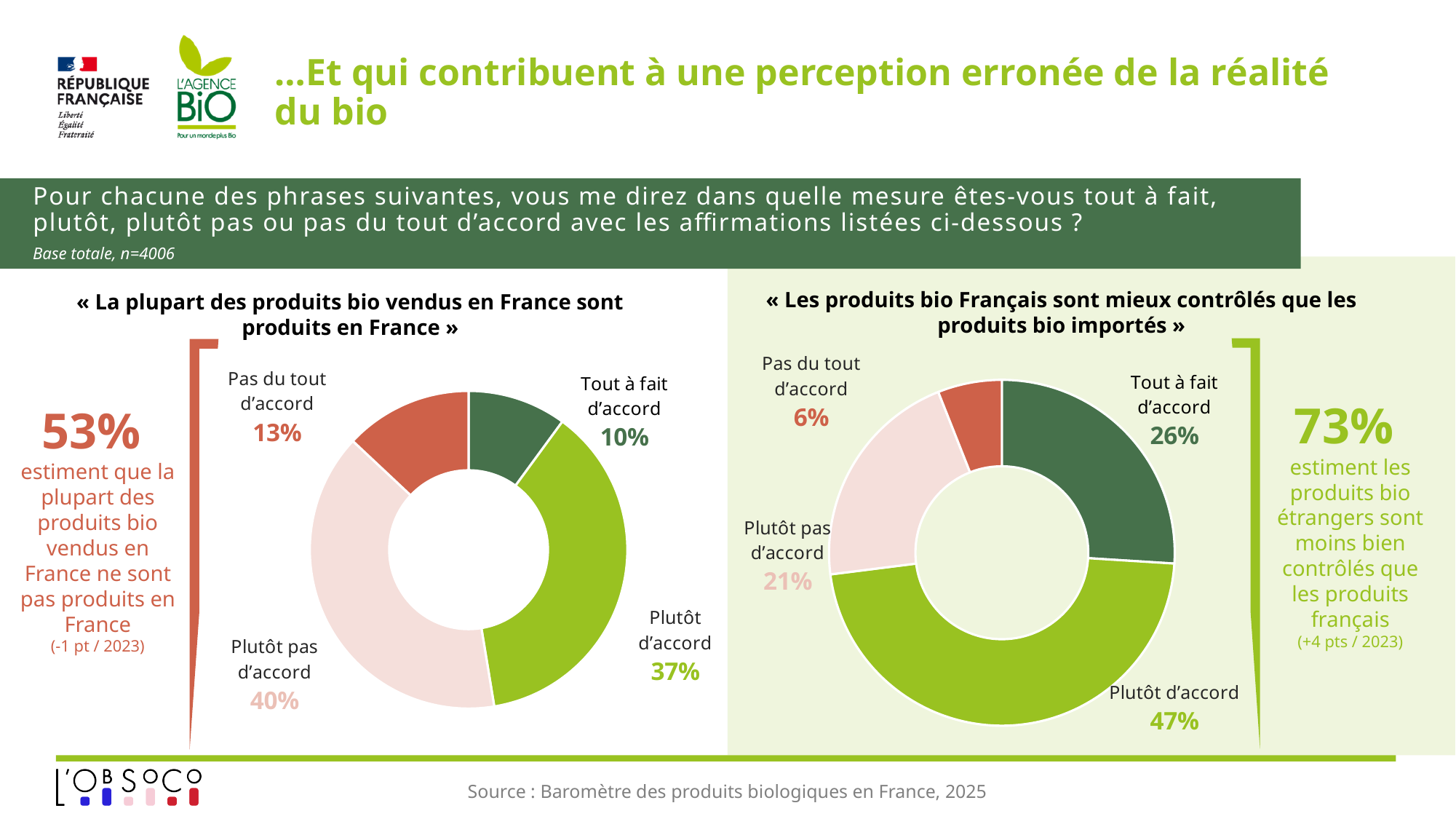
In the left chart (« La plupart des produits bio vendus en France sont produits en France »), which response has the largest share? Plutôt pas d'accord In the right chart (« Les produits bio Français sont mieux contrôlés que les produits bio importés »), which response has the smallest share? Pas du tout d'accord In the right chart (« Les produits bio Français sont mieux contrôlés que les produits bio importés »), which is larger: 'Tout à fait d'accord' or 'Plutôt pas d'accord'? Tout à fait d'accord What is the sample size (base) stated on the slide for the survey question? n=4006 In the left chart (« La plupart des produits bio vendus en France sont produits en France »), what is the difference between 'Plutôt d'accord' and 'Pas du tout d'accord'? 24 percentage points In the right chart (« Les produits bio Français sont mieux contrôlés que les produits bio importés »), what share is 'Pas du tout d'accord'? 6% How many response categories does the left chart (« La plupart des produits bio vendus en France sont produits en France ») show? 4 In the right chart (« Les produits bio Français sont mieux contrôlés que les produits bio importés »), what is the combined share of 'Tout à fait d'accord' and 'Plutôt d'accord'? 73% In the left chart (« La plupart des produits bio vendus en France sont produits en France »), what share is 'Plutôt pas d'accord'? 40% In the right chart (« Les produits bio Français sont mieux contrôlés que les produits bio importés »), what share is 'Plutôt d'accord'? 47% In the left chart (« La plupart des produits bio vendus en France sont produits en France »), what share is 'Tout à fait d'accord'? 10% What type of chart is used on the right side of the slide (« Les produits bio Français sont mieux contrôlés que les produits bio importés »)? Doughnut (pie) chart